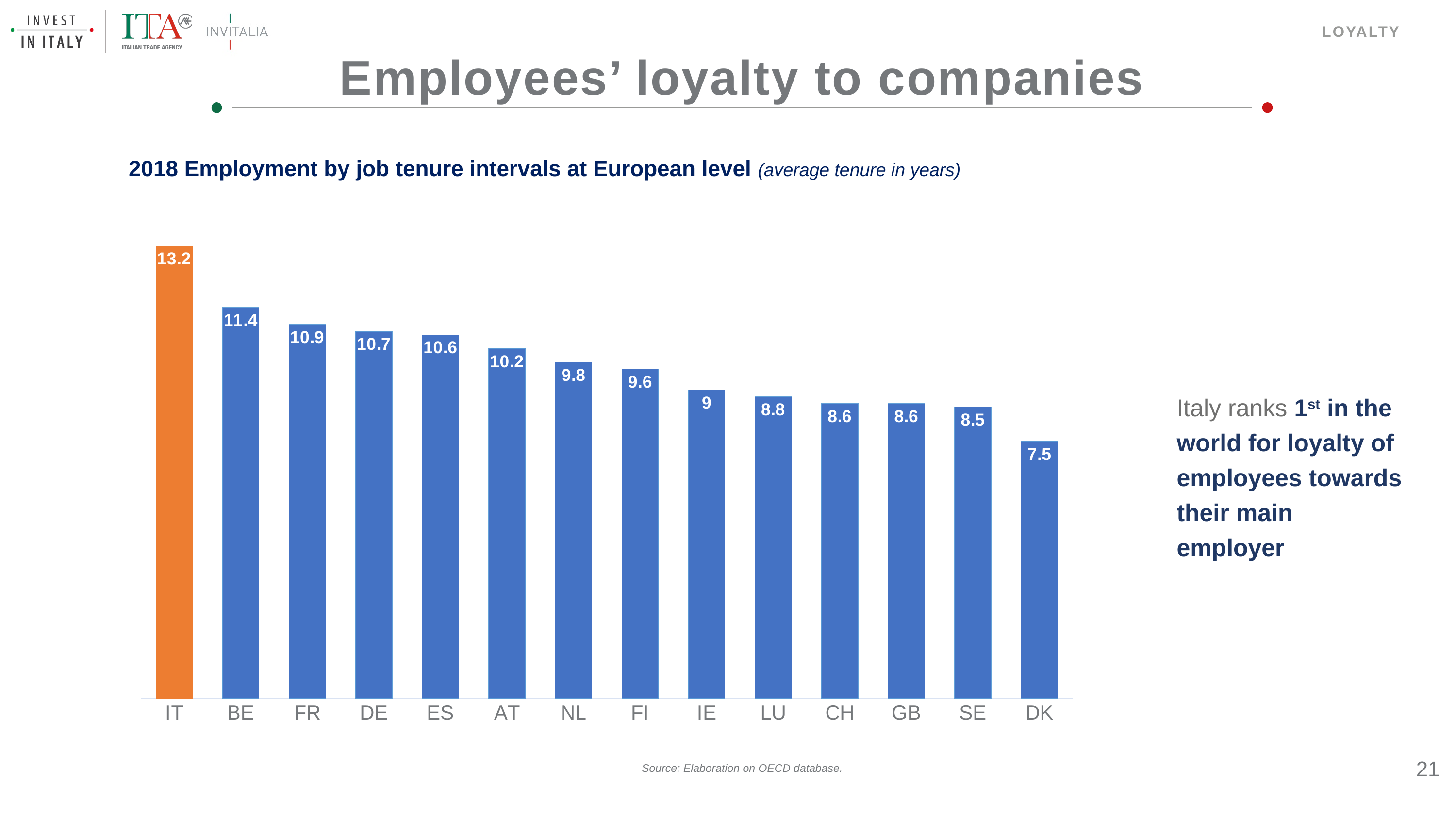
What is the average job tenure in years for DE? 10.7 Which country has the highest average job tenure? IT What is the average job tenure in years for IT? 13.2 What is the difference in average tenure between IT and BE? 1.8 What is the average job tenure in years for IE? 9 What is the difference in average tenure between FR and DK? 3.4 Which bar is coloured orange rather than blue? IT What kind of chart is shown on the slide? Bar chart Which has a higher average tenure, SE or ES? ES Which has a higher average tenure, AT or NL? AT How many countries are shown in the chart? 14 Which country has the lowest average job tenure? DK